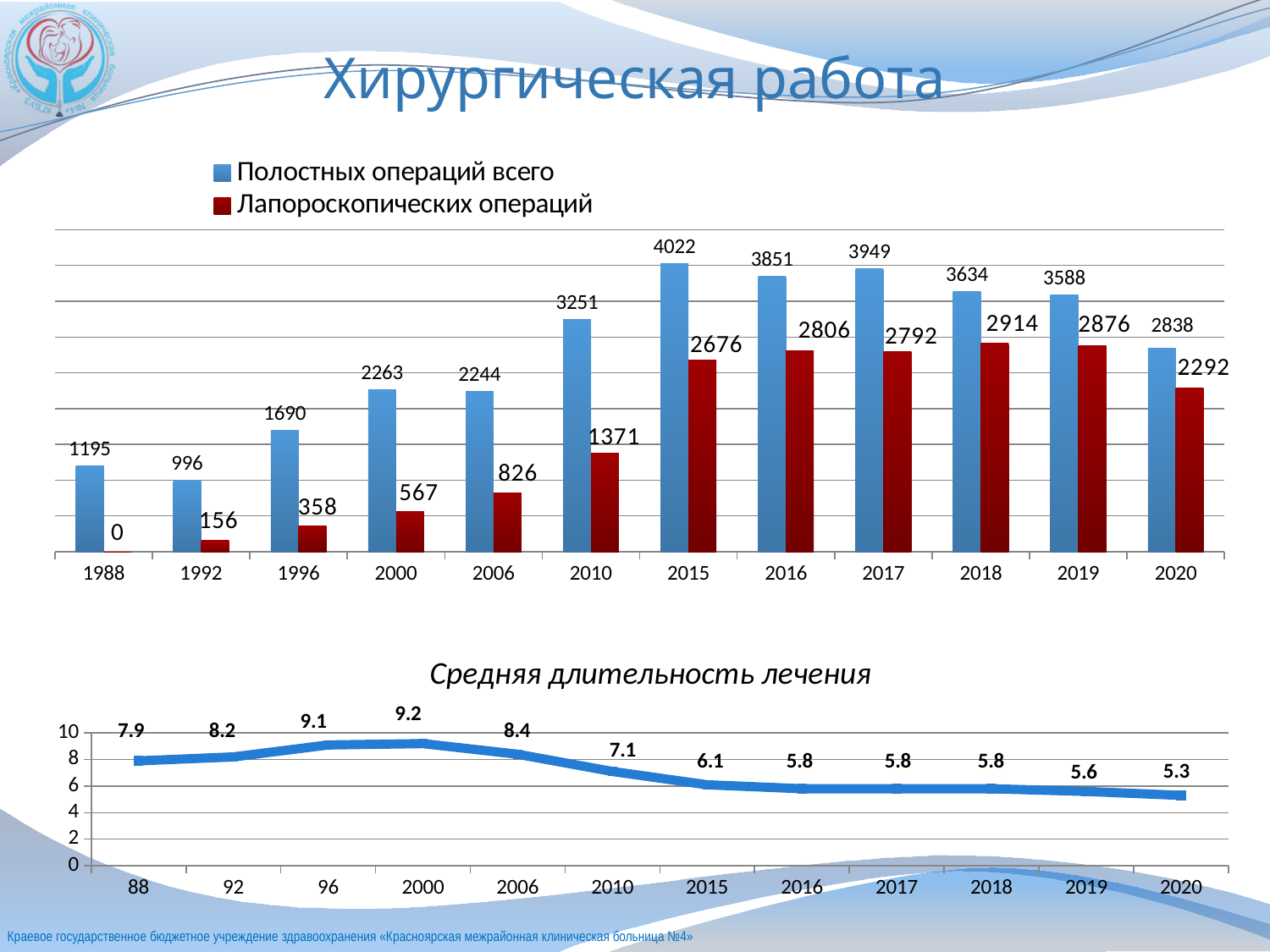
In the top bar chart, which year has the highest value for Полостных операций всего? 2015 In the top bar chart, what is the difference between Полостных операций всего and Лапороскопических операций in 2020? 546 In the chart titled Средняя длительность лечения, what is the value for 2000? 9.2 In the top bar chart, which is larger in 2016: Полостных операций всего or Лапороскопических операций? Полостных операций всего What kind of chart is the top chart on the slide? bar chart How many series does the legend of the top bar chart list? 2 In the chart titled Средняя длительность лечения, which year has the lowest value? 2020 In the top bar chart, what is the value of Полостных операций всего for 2015? 4022 In the top bar chart, which year has the lowest value for Лапороскопических операций? 1988 How many years are shown on the x axis of the top bar chart? 12 In the chart titled Средняя длительность лечения, do the values rise or fall from 2006 to 2020? fall In the top bar chart, what is the value of Лапороскопических операций for 2010? 1371